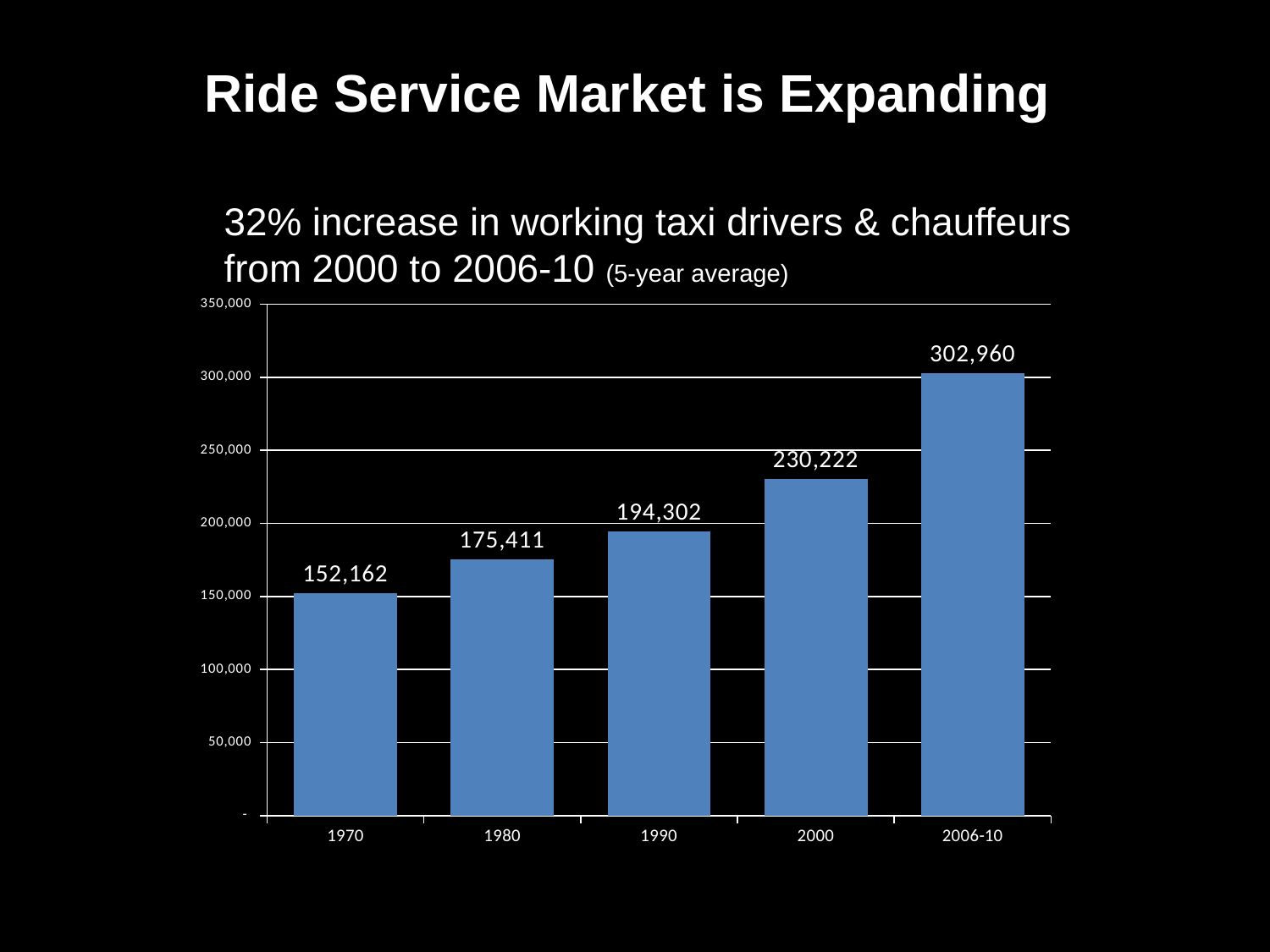
What is the value for 1990? 194,302 What is the value for 2006-10? 302,960 What is the difference between the values for 1980 and 1970? 23,249 What kind of chart is shown on the slide? bar chart What is the value for 1970? 152,162 How many categories are shown on the x axis? 5 What is the difference between the values for 2006-10 and 2000? 72,738 Which category has the lowest value? 1970 Is the value for 2000 greater or less than 250,000? less Which category has the highest value? 2006-10 Which is larger, the value for 1990 or the value for 2000? 2000 Do the values rise or fall from 1970 to 2006-10? rise